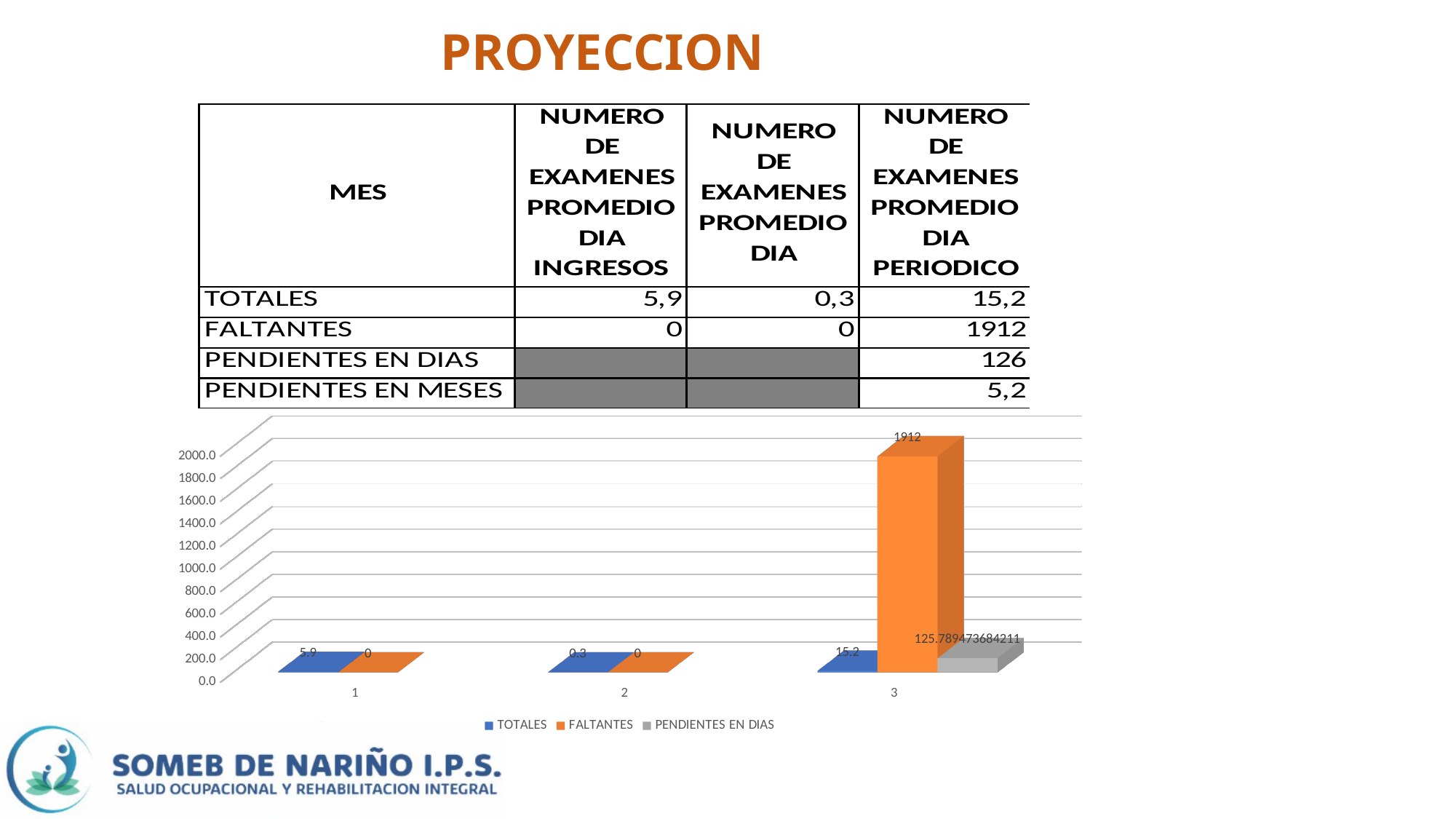
What is the difference between the TOTALES values for category 3 and category 1? 9.3 What is the value of the TOTALES series for category 1? 5.9 Which category has the highest FALTANTES value? 3 What is the value of the TOTALES series for category 2? 0.3 What kind of chart is shown on the slide? bar chart What is the data label shown for the PENDIENTES EN DIAS series at category 3? 125.789473684211 How many series does the chart legend list? 3 How many categories are shown on the x axis of the chart? 3 What is the value of the FALTANTES series for category 3? 1912 Which is larger for category 3: the TOTALES value or the FALTANTES value? FALTANTES What is the value of the TOTALES series for category 3? 15.2 Which series is shown in orange in the chart legend? FALTANTES